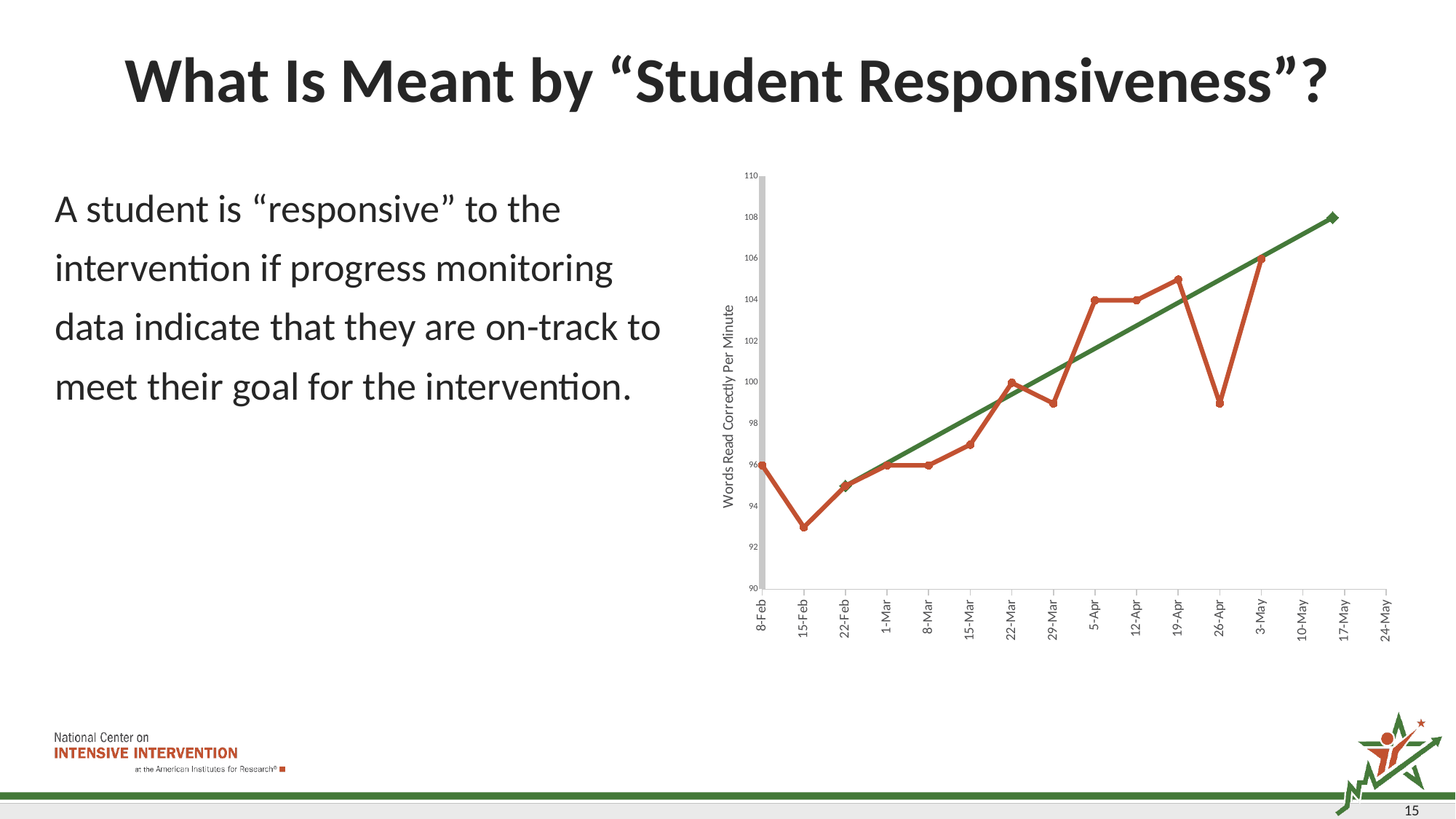
What value does the green goal line reach at 17-May? 108 Which is larger, the red line's value for 5-Apr or for 26-Apr? 5-Apr Is the value of the red line for 26-Apr greater or less than 100? less On which date does the red line reach its highest value? 3-May Is the value of the red line for 15-Feb greater or less than 94? less On which date does the red line reach its lowest value? 15-Feb Overall, does the red line rise or fall from 8-Feb to 3-May? rise What kind of chart is shown on the slide? line chart Is the value of the red line for 29-Mar greater or less than 98? greater How many dates are labelled along the x axis of the chart? 16 What is the label on the vertical axis of the chart? Words Read Correctly Per Minute